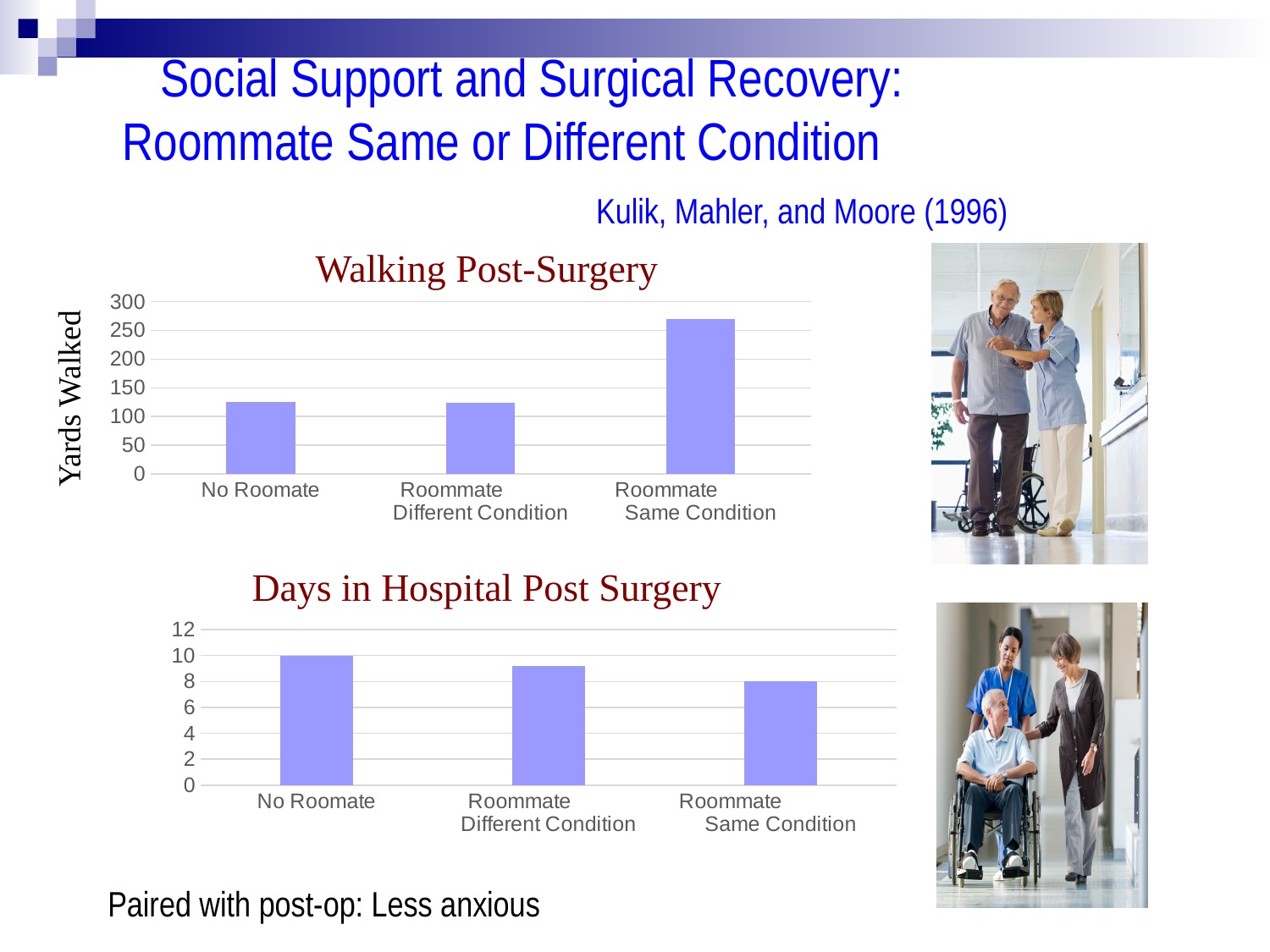
What is the y-axis label of the Walking Post-Surgery chart? Yards Walked In the Days in Hospital Post Surgery chart, do the values rise or fall from left to right? fall In the Walking Post-Surgery chart, which category has the highest value? Roommate Same Condition What type of chart is the Days in Hospital Post Surgery chart? bar chart In the Walking Post-Surgery chart, is the value for Roommate Different Condition greater or less than 100? greater In the Walking Post-Surgery chart, how many categories are shown? 3 In the Walking Post-Surgery chart, is the value for Roommate Same Condition greater or less than 250? greater In the Walking Post-Surgery chart, is the value for No Roomate greater or less than 150? less In the Days in Hospital Post Surgery chart, which category has the lowest value? Roommate Same Condition